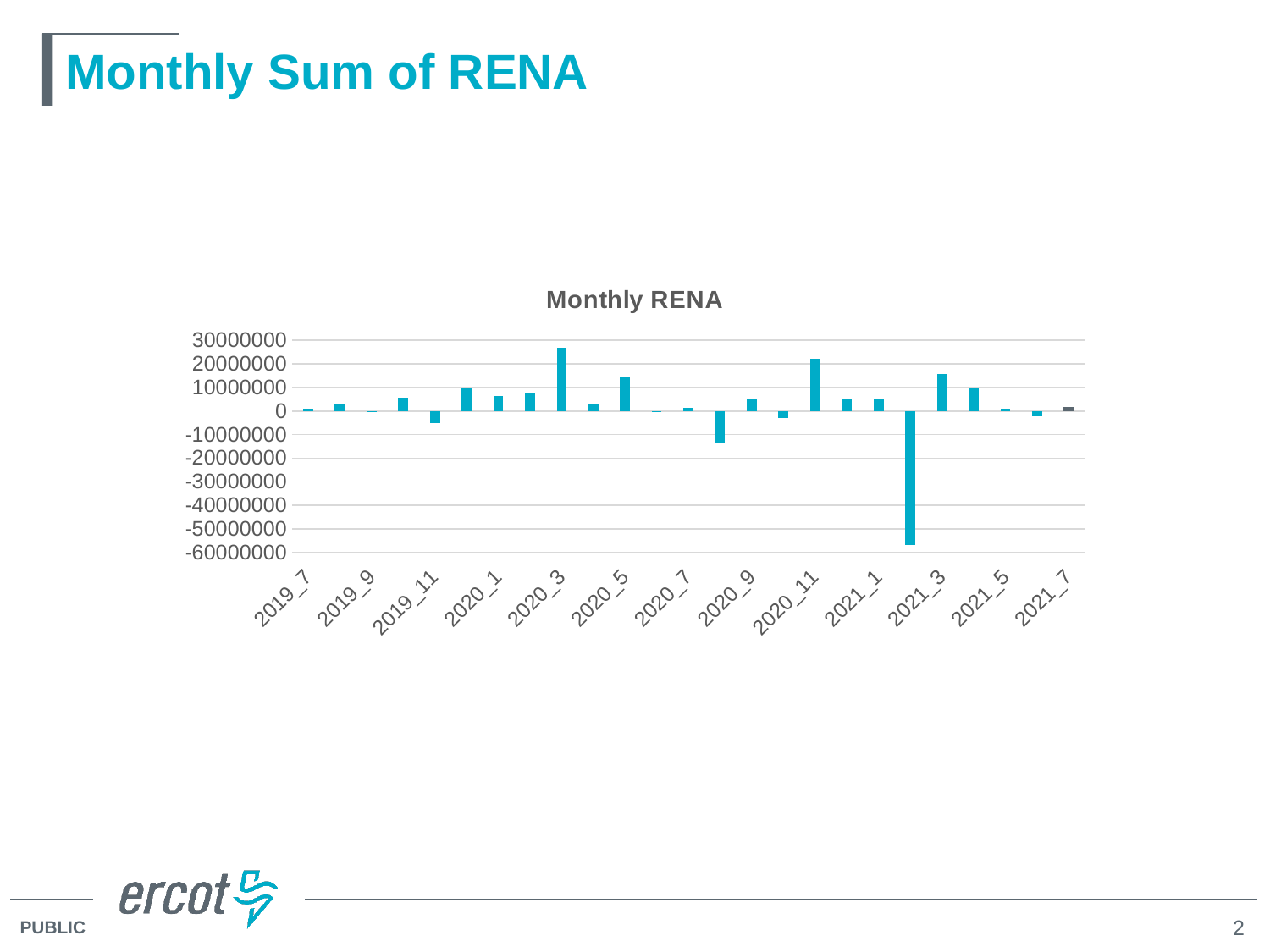
What kind of chart is shown on the slide? bar chart Which month has the highest Monthly RENA value? 2020_3 What is the title of the chart? Monthly RENA How many month labels are printed along the x axis? 13 Which is larger, the value for 2020_5 or the value for 2020_9? 2020_5 Is the value for 2020_11 greater or less than 10000000? greater Is the value for 2021_3 greater or less than 10000000? greater Is the value for 2021_5 greater or less than 10000000? less Which is larger, the value for 2020_3 or the value for 2020_11? 2020_3